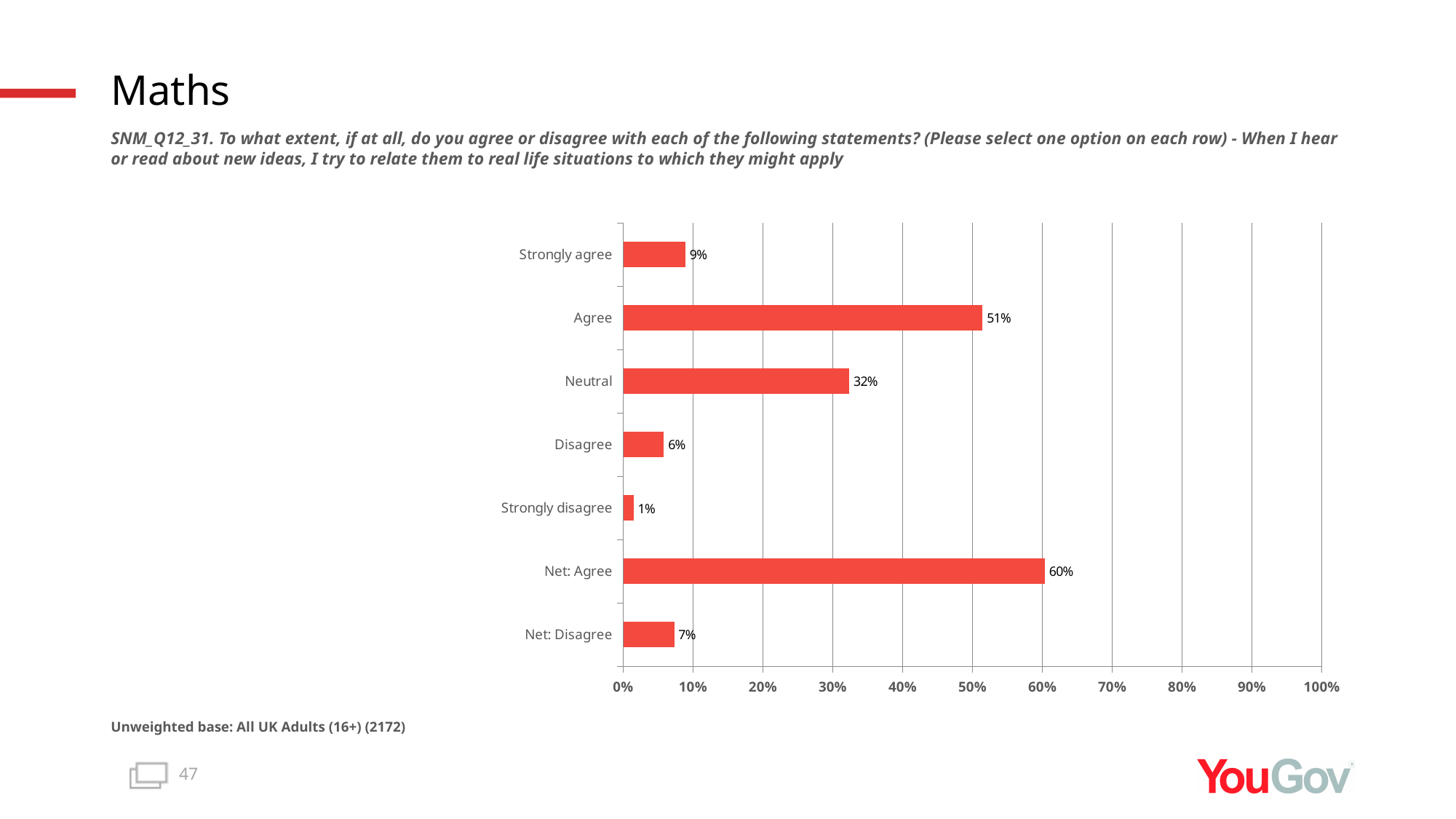
What is the value shown for 'Neutral'? 32% Which is larger, 'Strongly agree' or 'Disagree'? Strongly agree What kind of chart is shown on the slide? Bar chart Is the value for 'Agree' greater or less than 50%? greater What percentage of respondents selected 'Agree'? 51% Which category has the highest value? Net: Agree What is the value for 'Strongly disagree'? 1% What is the value for 'Net: Disagree'? 7% How many categories are shown on the chart? 7 What is the difference between 'Agree' and 'Neutral'? 19% Which category has the lowest value? Strongly disagree What is the difference between 'Net: Agree' and 'Net: Disagree'? 53%